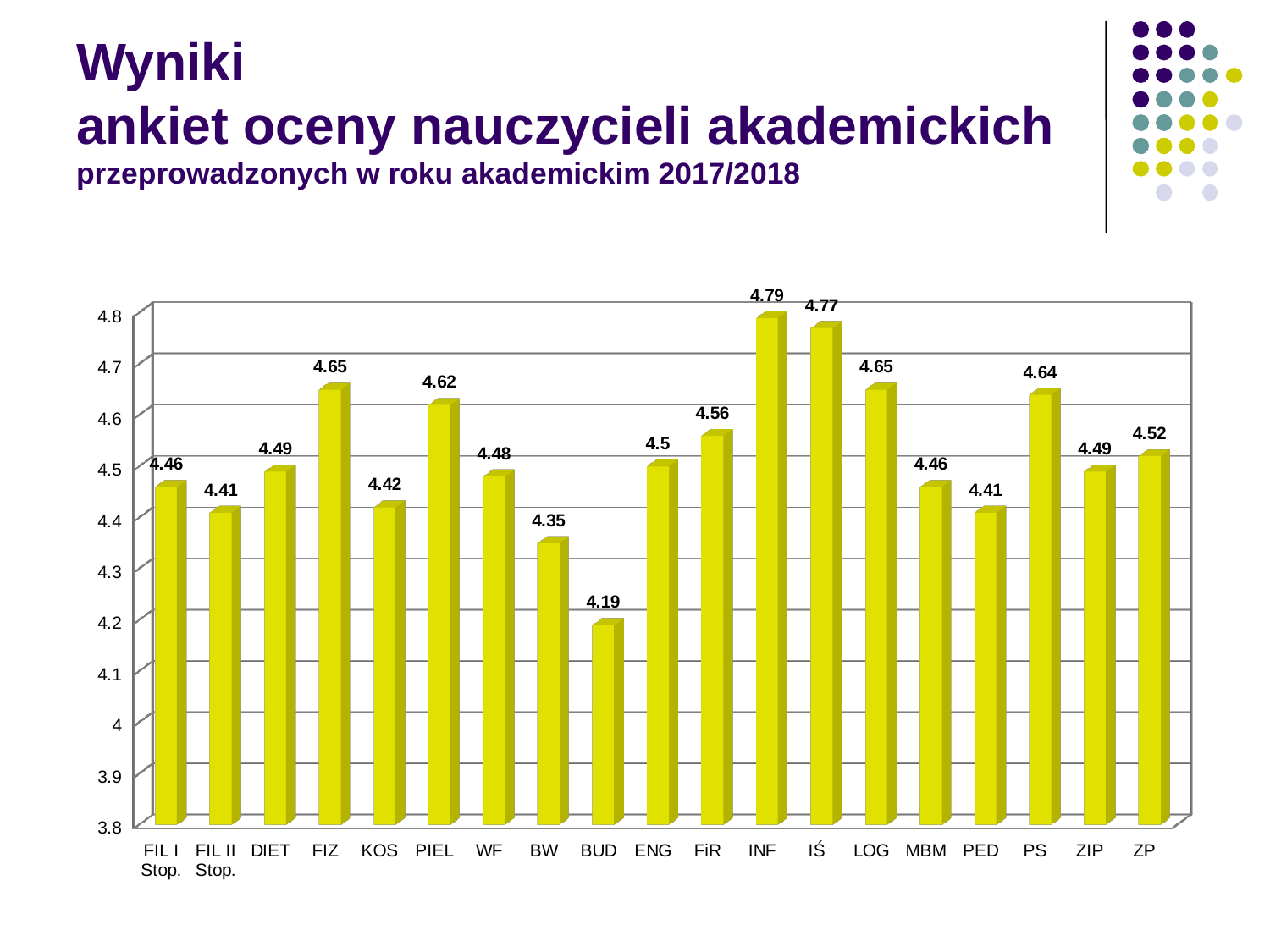
Which is larger, the value for PIEL or the value for WF? PIEL What is the value for PIEL? 4.62 What kind of chart is shown on the slide? bar chart What is the value for INF? 4.79 How many categories are shown on the x axis? 19 What is the value for BUD? 4.19 Is the value for BW greater or less than 4.4? less Which category has the highest value? INF What is the value for ZP? 4.52 Which category has the lowest value? BUD What is the difference between the values for FIZ and KOS? 0.23 What is the difference between the values for INF and BUD? 0.6